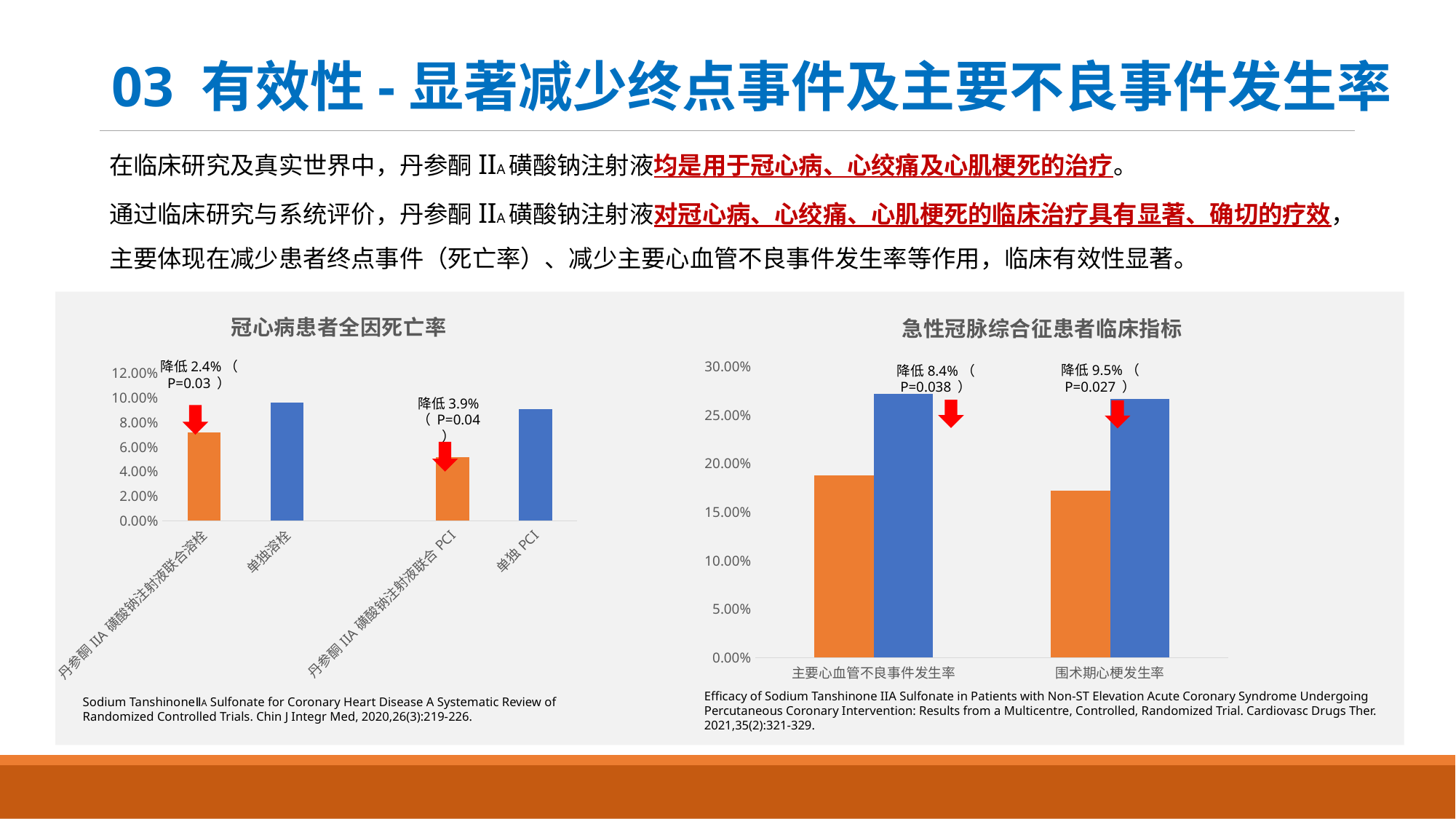
In the right chart titled 急性冠脉综合征患者临床指标, what reduction is annotated for 围术期心梗发生率? 降低9.5%（P=0.027） In the left chart titled 冠心病患者全因死亡率, which is larger: 丹参酮IIA磺酸钠注射液联合溶栓 or 单独溶栓? 单独溶栓 In the right chart titled 急性冠脉综合征患者临床指标, is the blue bar for 围术期心梗发生率 greater or less than 25.00%? greater How many bars are plotted in the left chart titled 冠心病患者全因死亡率? 4 What is the title of the right chart? 急性冠脉综合征患者临床指标 What type of chart is the left chart titled 冠心病患者全因死亡率? bar chart In the left chart titled 冠心病患者全因死亡率, is the value for 单独溶栓 greater or less than 8.00%? greater How many categories are shown on the x axis of the right chart titled 急性冠脉综合征患者临床指标? 2 In the left chart titled 冠心病患者全因死亡率, which bar is the lowest? 丹参酮IIA磺酸钠注射液联合PCI In the left chart titled 冠心病患者全因死亡率, is the value for 丹参酮IIA磺酸钠注射液联合PCI greater or less than 6.00%? less In the left chart titled 冠心病患者全因死亡率, what reduction is annotated for the combination with PCI compared with PCI alone? 降低3.9%（P=0.04）